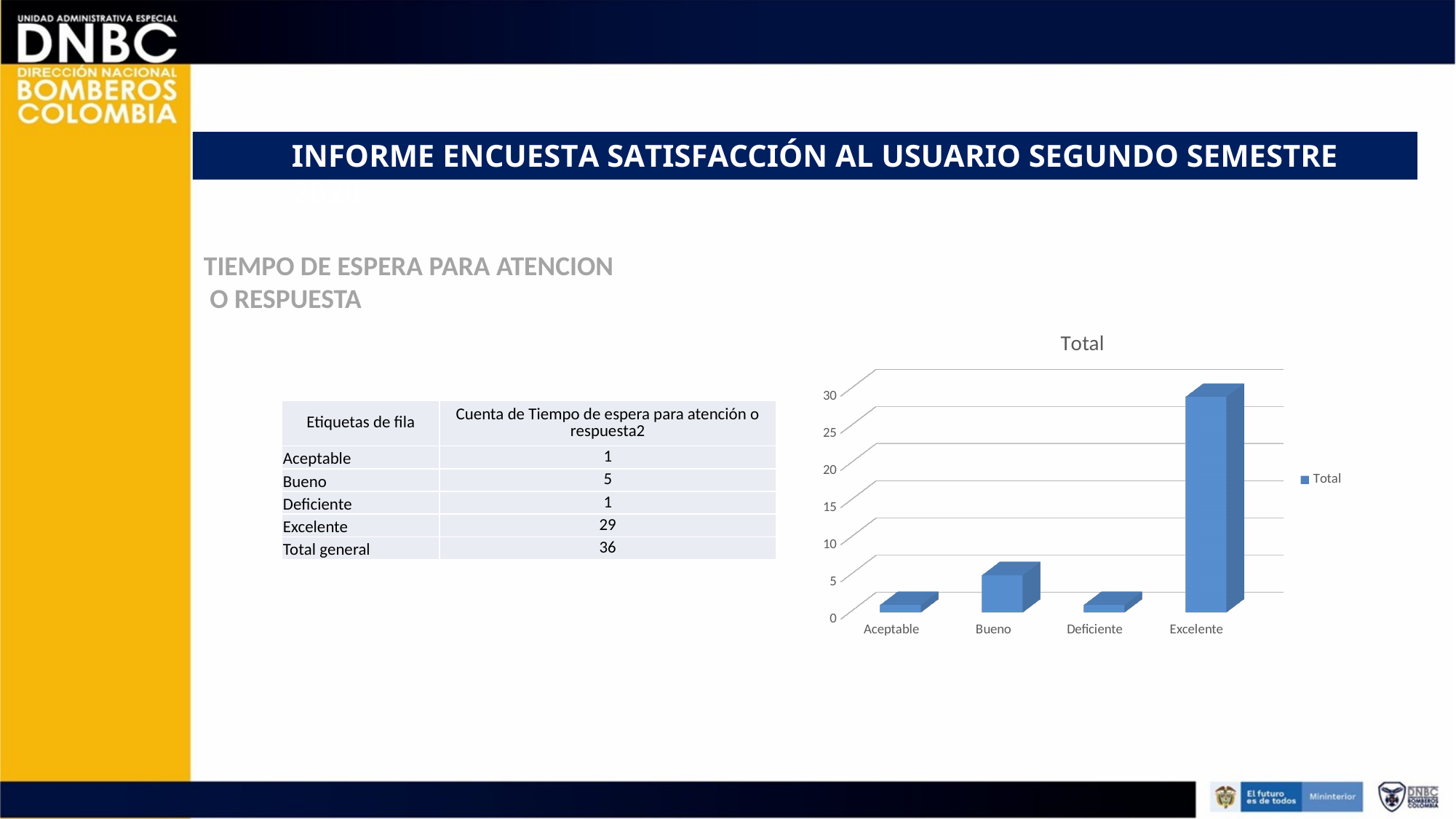
How many series does the chart legend list? 1 What type of chart is shown on the slide? bar chart According to the table, what is the count for Bueno? 5 According to the table, what is the count for Excelente? 29 Is the value for Excelente in the chart greater or less than 25? greater Which is larger in the chart, Bueno or Deficiente? Bueno Using the table values, what is the difference between Excelente and Bueno? 24 How many categories are shown on the x axis of the chart? 4 Which category has the highest value in the chart? Excelente What is the title of the chart? Total What is the Total general shown in the table? 36 According to the table, what is the count for Aceptable? 1